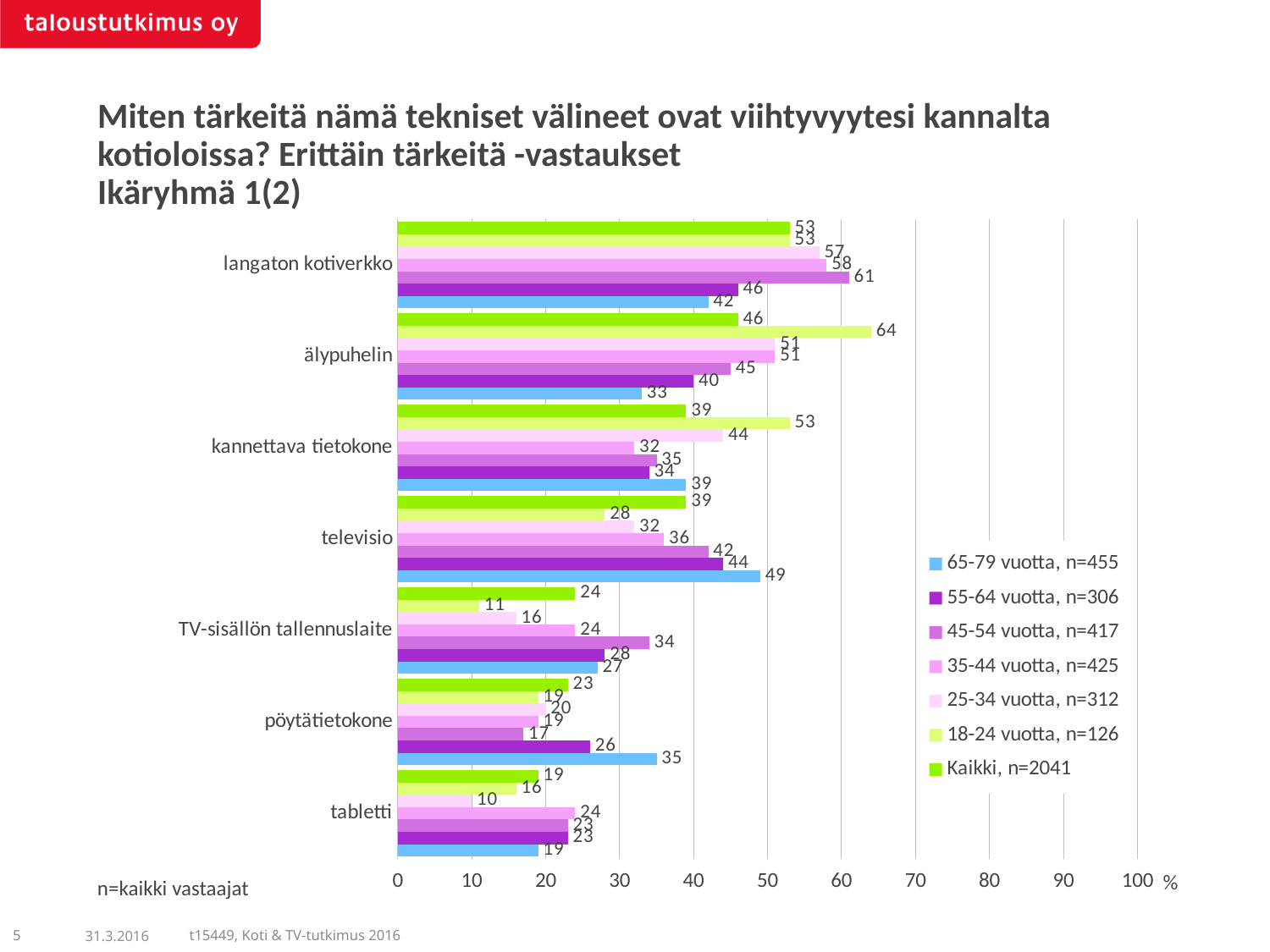
What is the value for '65-79 vuotta, n=455' for 'televisio'? 49 How many categories (devices) are shown on the chart? 7 Is the value for '45-54 vuotta, n=417' for 'langaton kotiverkko' greater or less than 50? greater What is the difference between the '18-24 vuotta, n=126' value and the '65-79 vuotta, n=455' value for 'älypuhelin'? 31 What is the value for 'Kaikki, n=2041' for 'langaton kotiverkko'? 53 What kind of chart is shown on the slide? bar chart How many series does the legend list? 7 What is the value for '45-54 vuotta, n=417' for 'TV-sisällön tallennuslaite'? 34 Which age group has the lowest value for 'tabletti'? 25-34 vuotta, n=312 Which age group has the highest value for 'pöytätietokone'? 65-79 vuotta, n=455 For 'kannettava tietokone', which is larger: the value for '18-24 vuotta, n=126' or for '35-44 vuotta, n=425'? 18-24 vuotta, n=126 What is the value for '18-24 vuotta, n=126' for 'älypuhelin'? 64